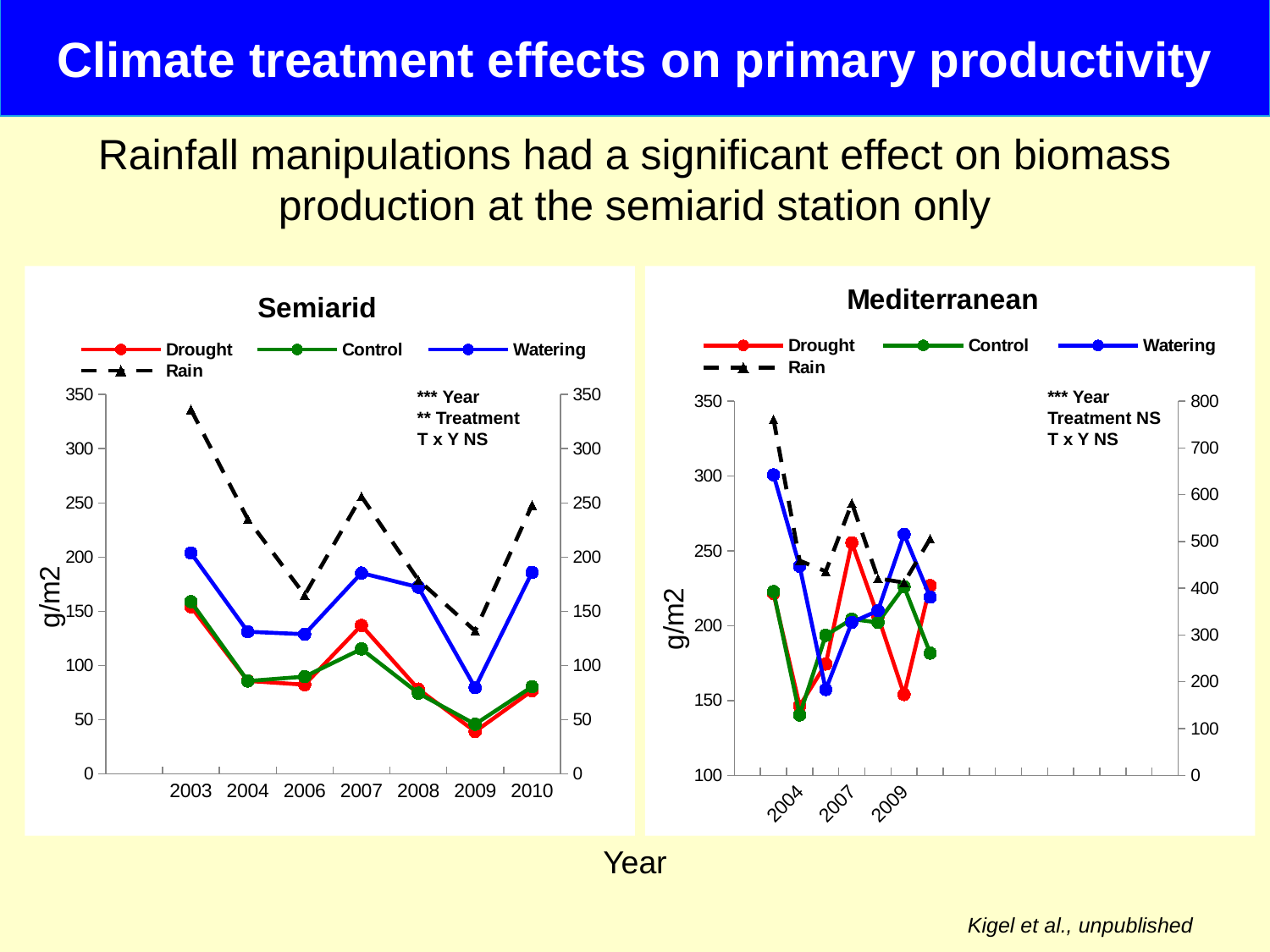
How many years are shown on the x axis of the Semiarid chart? 7 In the Semiarid chart, is the Watering value for 2007 greater or less than 150? greater In the Semiarid chart, which year has the lowest Watering value? 2009 In the Semiarid chart, is the Watering value for 2009 greater or less than 100? less In the Semiarid chart, does the Rain line rise or fall from 2003 to 2006? fall What type of chart is the Semiarid chart? line chart In the Semiarid chart, is the Drought value for 2009 greater or less than 50? less In the Semiarid chart, which is larger in 2003, the Watering value or the Drought value? Watering What is the title of the chart on the right side of the slide? Mediterranean In the Semiarid chart, which year has the highest Rain value? 2003 How many series does the legend of the Semiarid chart list? 4 How many series does the legend of the Mediterranean chart list? 4